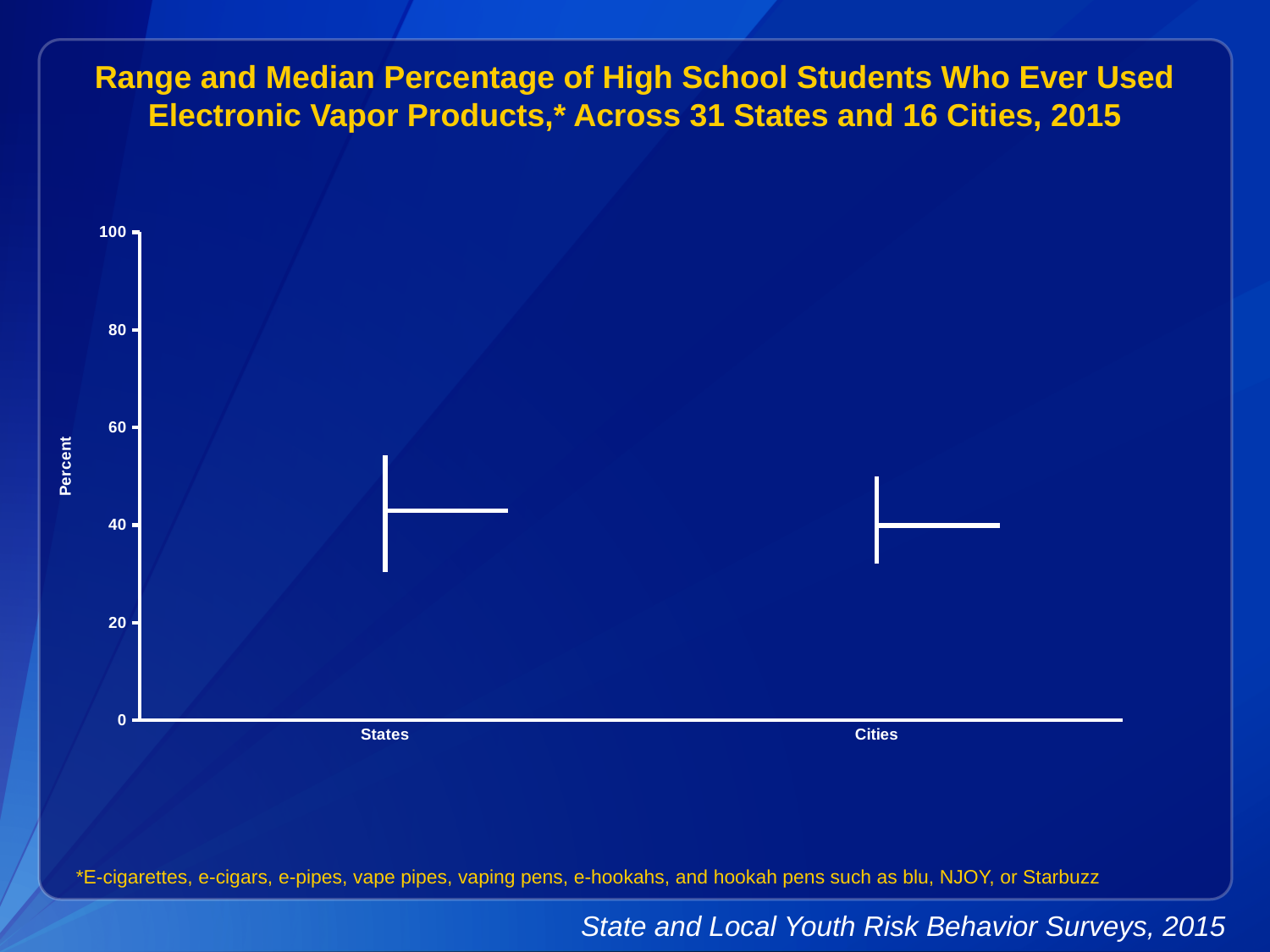
Is the median for States greater or less than 60? less Is the top of the range for States greater or less than 40? greater Which category has the higher top of its range, States or Cities? States What are the two categories shown on the x axis? States and Cities Is the bottom of the range for States greater or less than 40? less How many categories are shown on the x axis of the chart? 2 What is the label on the y axis of the chart? Percent